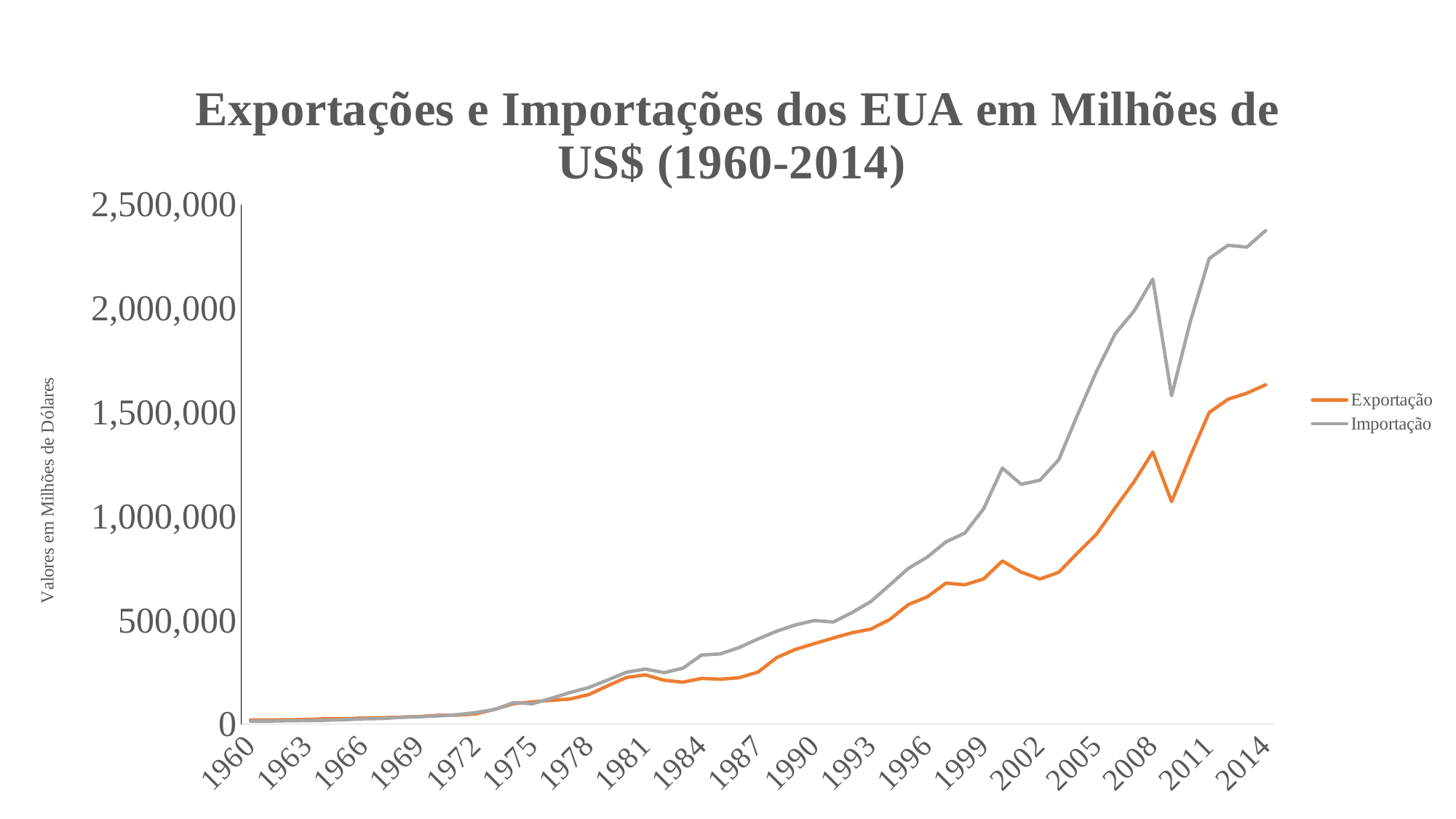
In 2014, which series has the larger value, Exportação or Importação? Importação What is the title of the chart? Exportações e Importações dos EUA em Milhões de US$ (1960-2014) How many year labels are shown on the x axis? 19 Is the value for Exportação in 1990 greater or less than 500,000? less Is the value for Importação in 2014 greater or less than 2,000,000? greater What are the two series named in the legend? Exportação and Importação How many series does the legend list? 2 Is the value for Exportação in 2014 greater or less than 1,500,000? greater What kind of chart is shown on the slide? line chart In which year does the Importação series reach its highest value? 2014 Overall, do the Exportação values rise or fall from 1960 to 2014? rise